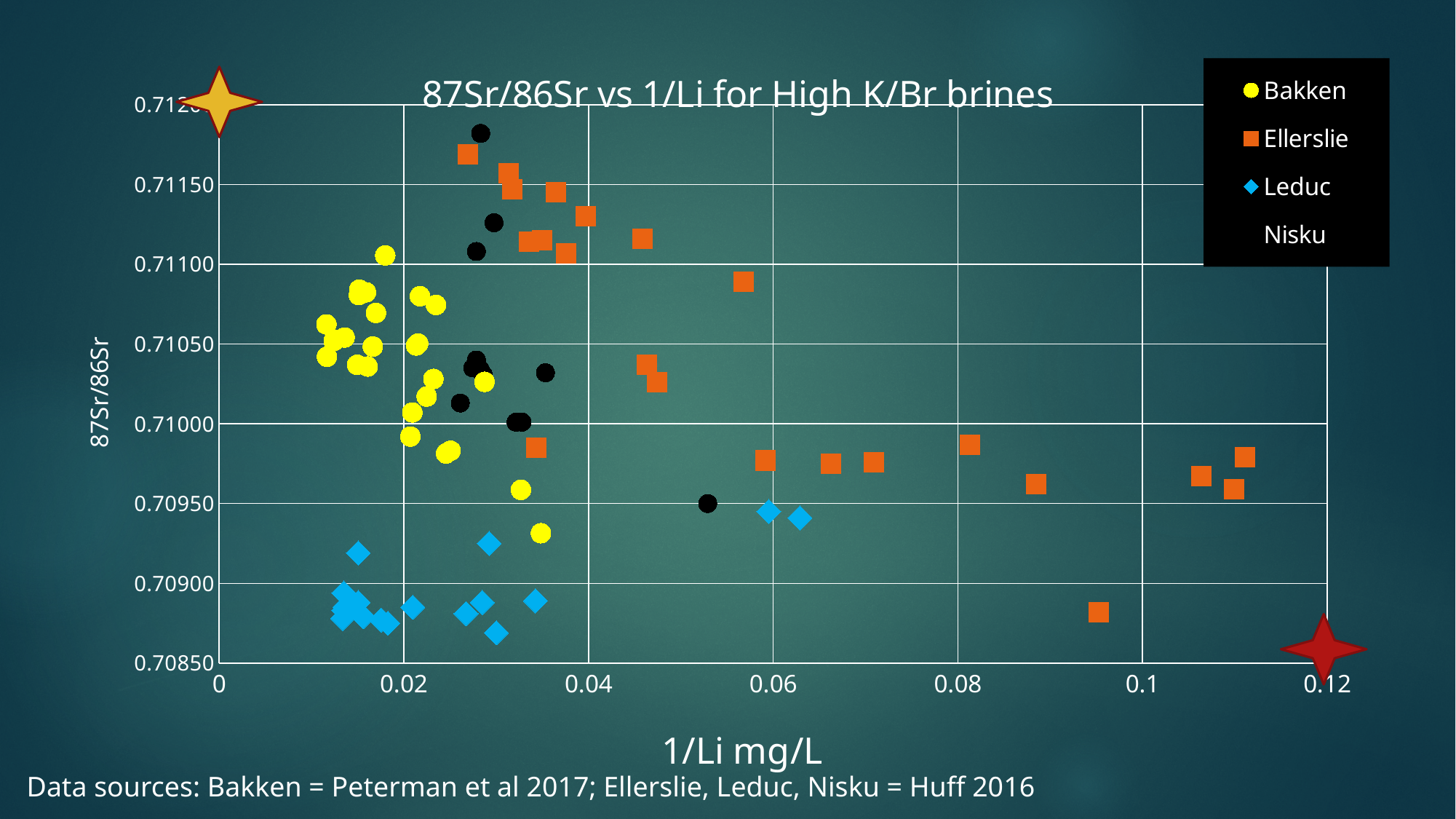
Which series has the lowest 87Sr/86Sr value on the chart? Leduc Are all Bakken points at 1/Li values less or greater than 0.04? less Which series is plotted with blue diamond markers? Leduc Which series has the point with the highest 87Sr/86Sr value on the chart? Nisku What kind of chart is shown on the slide? scatter chart What is the label of the x axis? 1/Li mg/L Are all Leduc points greater or less than 0.71000 on the 87Sr/86Sr axis? less What is the maximum value shown on the x axis? 0.12 Which series has the point furthest to the right along the 1/Li axis? Ellerslie Are all Bakken points greater or less than 0.70900 on the 87Sr/86Sr axis? greater How many series does the legend list? 4